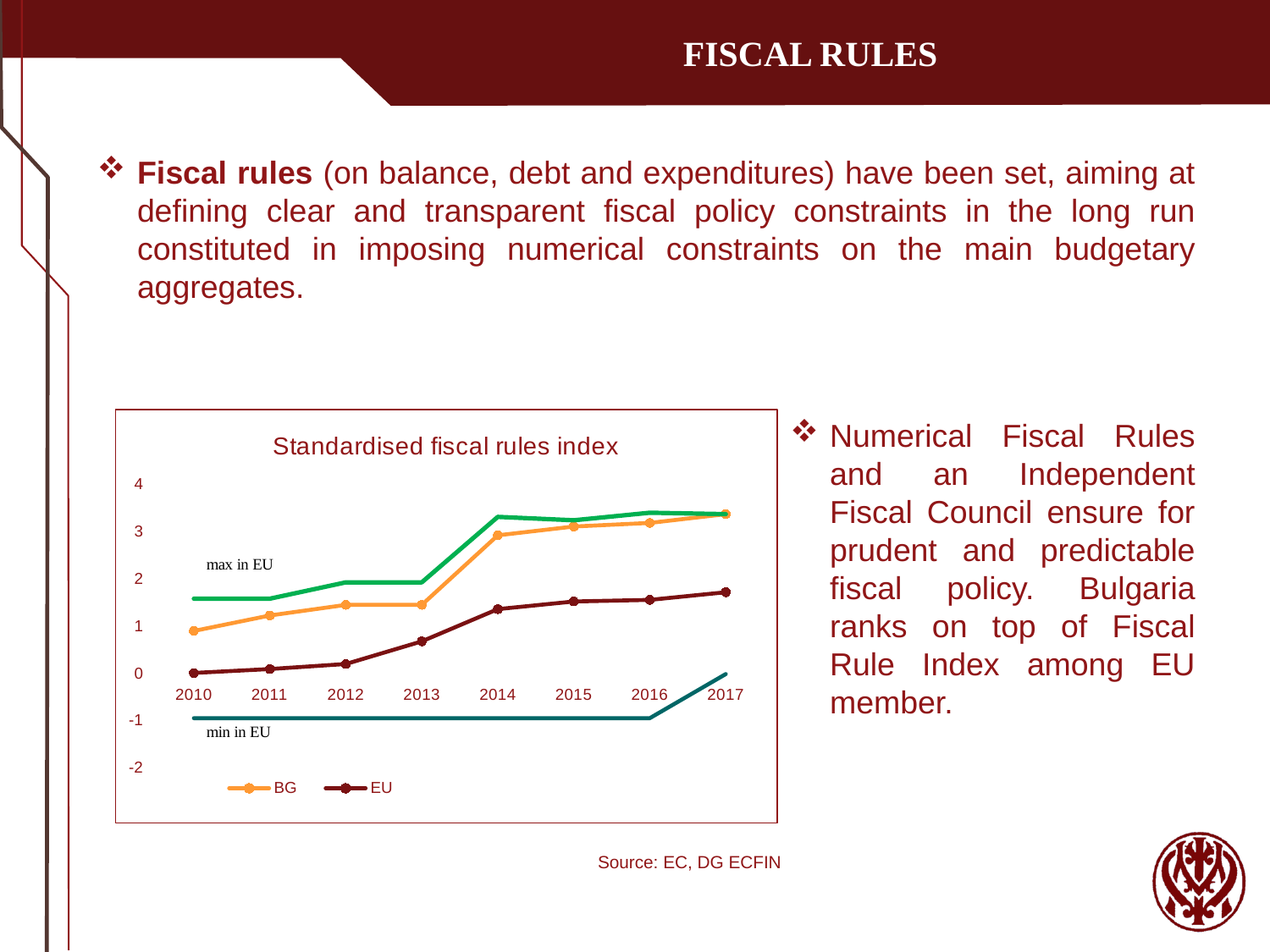
In which year is the EU series at its lowest? 2010 What is the title of the chart? Standardised fiscal rules index Is the value for BG in 2012 greater or less than 1? greater In which year is the BG series at its highest? 2017 Is the value for EU in 2017 greater or less than 2? less How many years are shown on the x axis of the chart? 8 Does the BG series rise or fall from 2010 to 2017? rise What kind of chart is shown on the slide? line chart How many series does the chart legend list? 2 In 2015, which series has the larger value, BG or EU? BG Is the value for BG in 2017 greater or less than 3? greater Which series is drawn in orange in the chart? BG